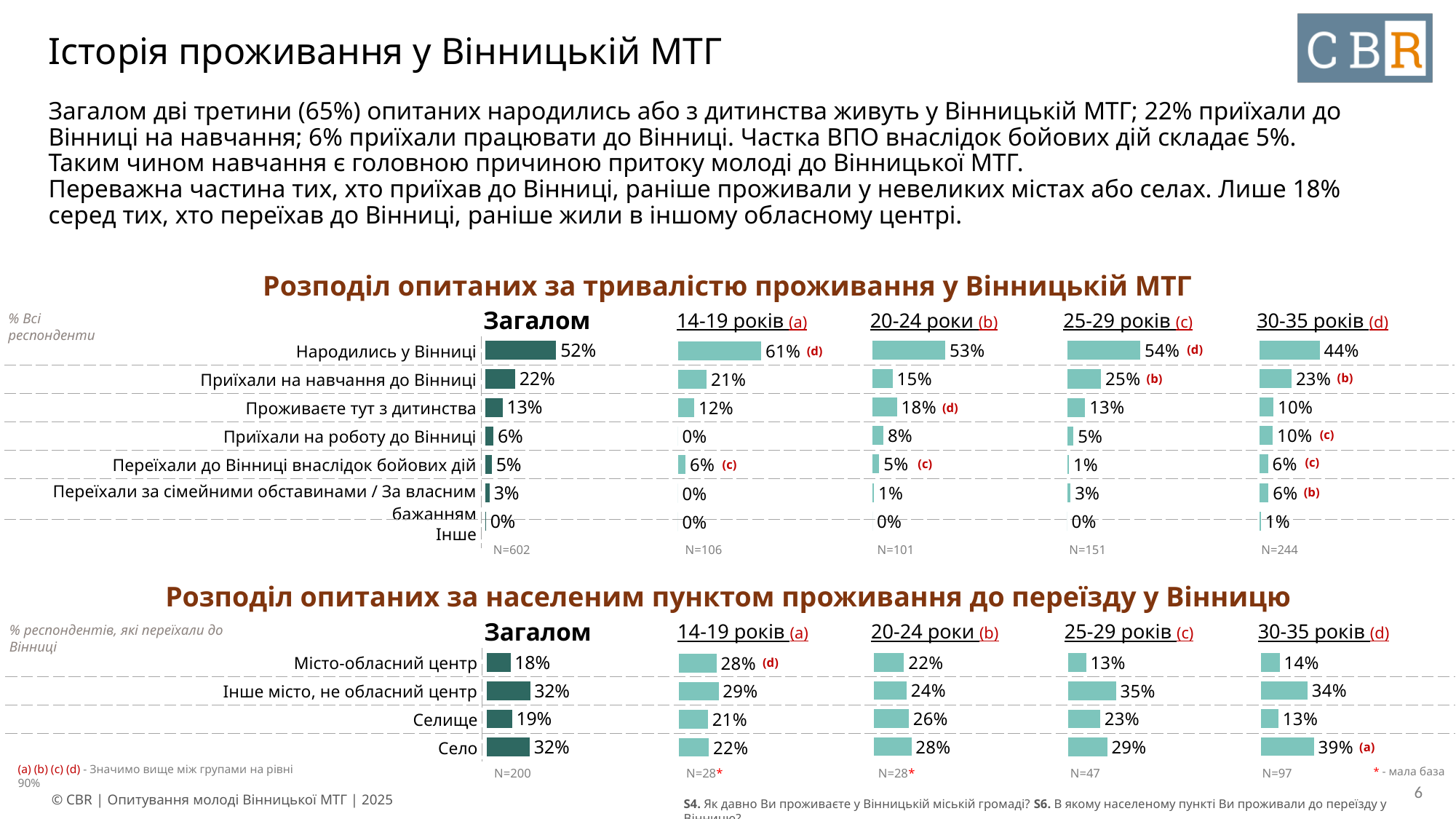
What type of chart is used on this slide to show the distributions? Bar chart In the chart "Розподіл опитаних за тривалістю проживання у Вінницькій МТГ", is the value for "Народились у Вінниці" larger in the "25-29 років" column or the "30-35 років" column? 25-29 років In the chart "Розподіл опитаних за населеним пунктом проживання до переїзду у Вінницю", which category has the lowest value in the "25-29 років" column? Місто-обласний центр In the chart "Розподіл опитаних за тривалістю проживання у Вінницькій МТГ", what is the difference between the "Загалом" values for "Народились у Вінниці" and "Приїхали на навчання до Вінниці"? 30 percentage points In the chart "Розподіл опитаних за тривалістю проживання у Вінницькій МТГ", what is the "Загалом" value for "Народились у Вінниці"? 52% In the chart "Розподіл опитаних за населеним пунктом проживання до переїзду у Вінницю", which category has the highest value in the "30-35 років" column? Село In the chart "Розподіл опитаних за населеним пунктом проживання до переїзду у Вінницю", what is the "Загалом" value for "Село"? 32% In the chart "Розподіл опитаних за тривалістю проживання у Вінницькій МТГ", what is the value for "Народились у Вінниці" in the "14-19 років" column? 61% In the chart "Розподіл опитаних за населеним пунктом проживання до переїзду у Вінницю", what is the sample size (N) shown under the "Загалом" column? N=200 In the chart "Розподіл опитаних за тривалістю проживання у Вінницькій МТГ", which category has the highest "Загалом" value? Народились у Вінниці In the chart "Розподіл опитаних за населеним пунктом проживання до переїзду у Вінницю", what is the difference between "Інше місто, не обласний центр" and "Село" in the "14-19 років" column? 7 percentage points How many categories (rows) are shown in the chart "Розподіл опитаних за тривалістю проживання у Вінницькій МТГ"? 7